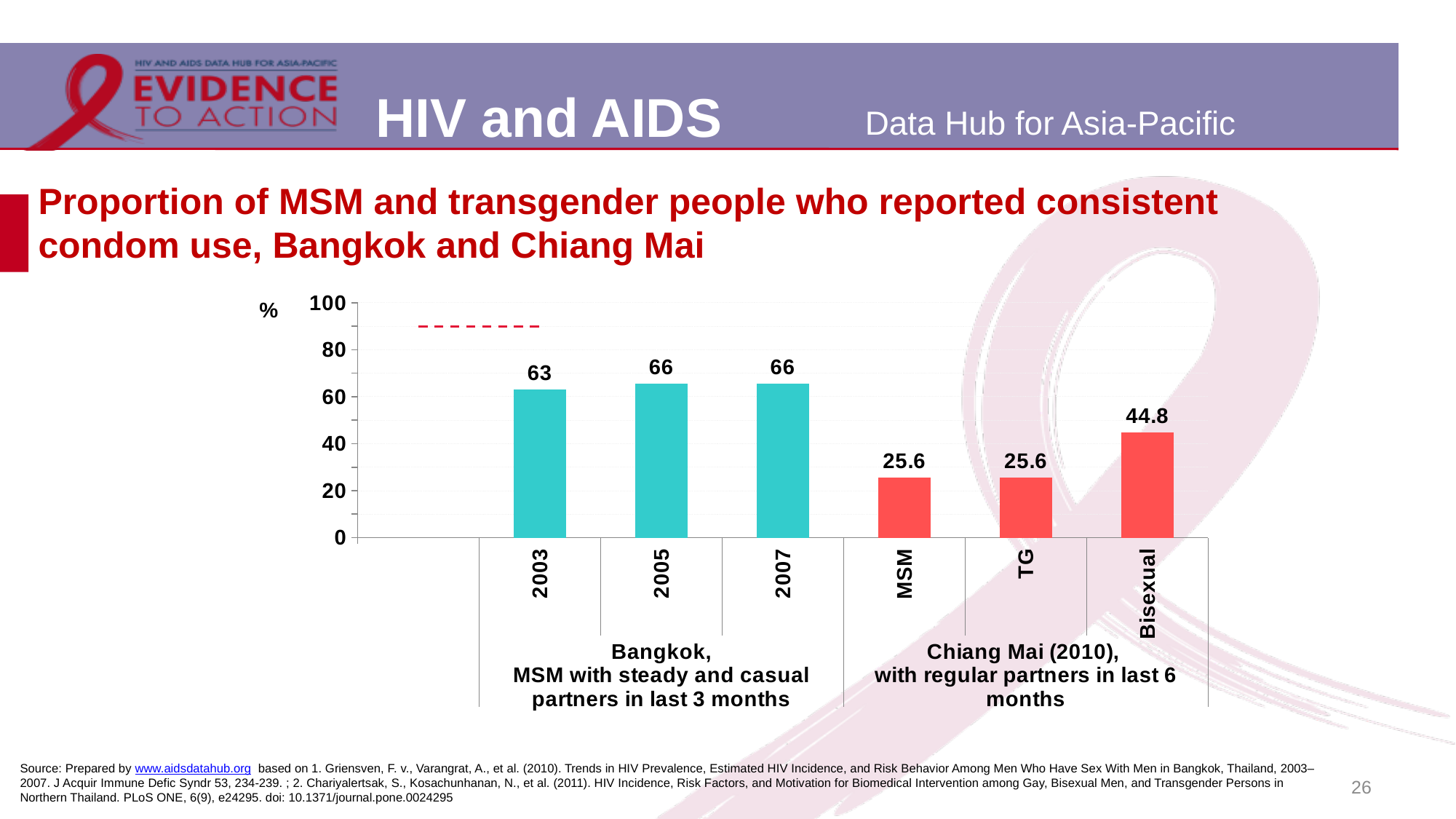
Which category has the lowest value on the chart? MSM and TG (both 25.6) What is the value for Bisexual in the Chiang Mai (2010) group? 44.8 What kind of chart is shown on the slide? Bar chart Which is larger, the value for 2003 in Bangkok or the value for Bisexual in Chiang Mai? 2003 in Bangkok What is the difference between the Bisexual value and the MSM value in the Chiang Mai (2010) group? 19.2 What is the value for TG in the Chiang Mai (2010) group? 25.6 Is the value for Bisexual in the Chiang Mai (2010) group greater or less than 40? greater What colour are the bars for the Chiang Mai (2010) group? Red What is the difference between the 2005 value and the 2003 value in the Bangkok group? 3 How many bars are plotted on the chart? 6 What is the value for 2007 in the Bangkok group? 66 What is the value for 2003 in the Bangkok group? 63